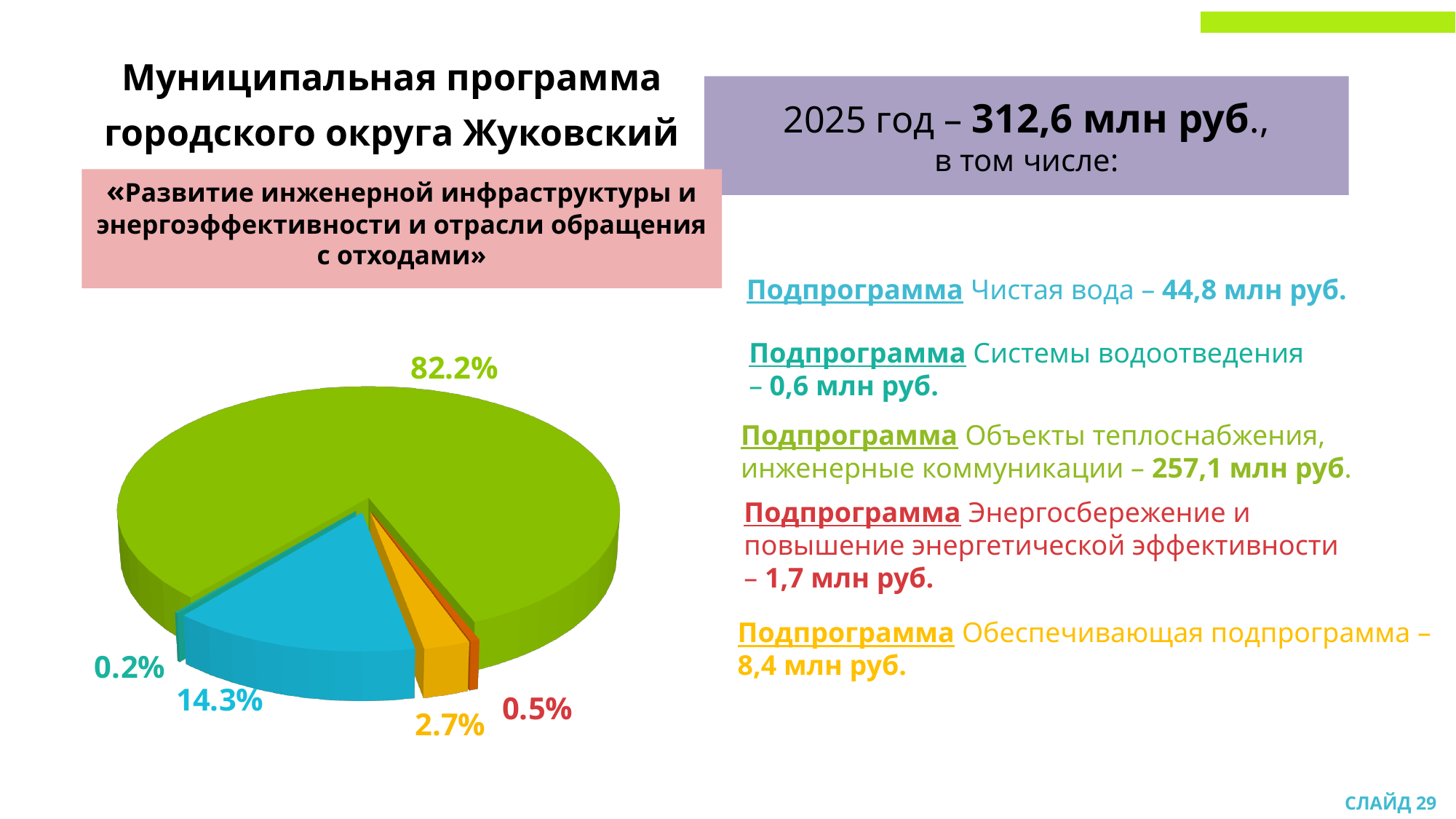
What kind of chart is shown on the slide? pie chart What share does the yellow slice of the pie chart represent? 2.7% What share does the red slice of the pie chart represent? 0.5% How many slices does the pie chart have? 5 What share does the blue slice of the pie chart represent? 14.3% What is the total programme amount for 2025 stated on the slide? 312,6 млн руб. What colour is the slice labelled 82.2%? green What is the smallest share shown on the pie chart? 0.2% Which slice is larger: the yellow slice or the red slice? the yellow slice (2.7%) What is the largest share shown on the pie chart? 82.2% What is the difference in percentage points between the green slice (82.2%) and the blue slice (14.3%)? 67.9 Is the share of the green slice greater or less than 80%? greater